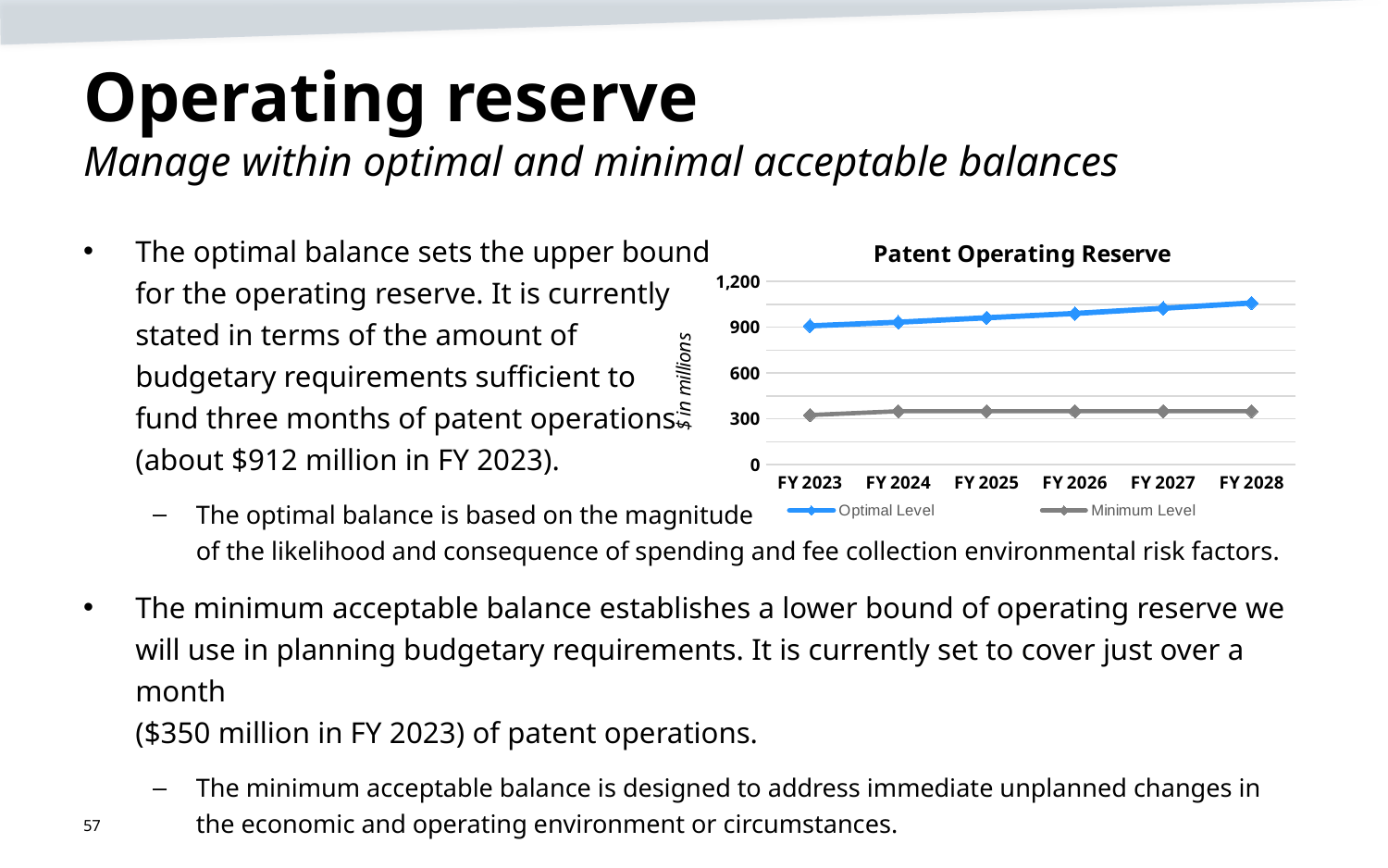
In which fiscal year is the Optimal Level highest? FY 2028 In which fiscal year is the Optimal Level lowest? FY 2023 What is the title of the chart on the slide? Patent Operating Reserve In FY 2025, which series has the larger value, Optimal Level or Minimum Level? Optimal Level What is the label on the vertical axis of the Patent Operating Reserve chart? $ in millions How many fiscal years are shown on the x axis of the Patent Operating Reserve chart? 6 How many series does the legend of the Patent Operating Reserve chart list? 2 Is the Minimum Level value for FY 2027 greater or less than 600? less Is the Optimal Level value for FY 2028 greater or less than 900? greater Does the Optimal Level series rise or fall from FY 2023 to FY 2028? rise What type of chart is the Patent Operating Reserve chart? line chart Is the Optimal Level value for FY 2023 greater or less than 600? greater